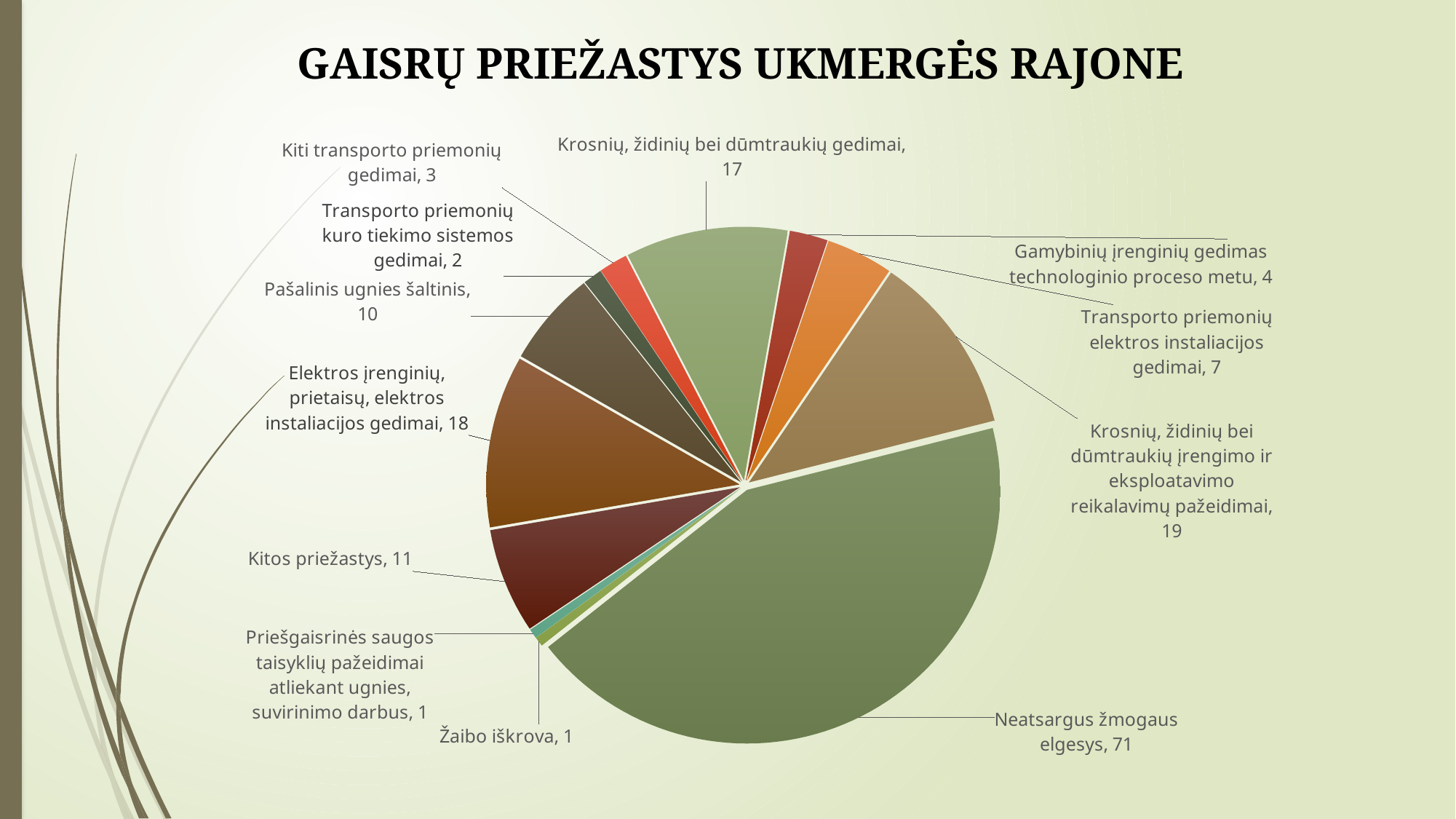
Which category has the highest value? Neatsargus žmogaus elgesys What is the value for Kitos priežastys? 11 What is the value for Neatsargus žmogaus elgesys? 71 What is the value for Pašalinis ugnies šaltinis? 10 What is the difference between Neatsargus žmogaus elgesys and Krosnių, židinių bei dūmtraukių įrengimo ir eksploatavimo reikalavimų pažeidimai? 52 What is the difference between Elektros įrenginių, prietaisų, elektros instaliacijos gedimai and Krosnių, židinių bei dūmtraukių gedimai? 1 What is the value for Transporto priemonių elektros instaliacijos gedimai? 7 What type of chart is shown on the slide? pie chart How many categories (slices) does the pie chart have? 12 What is the title of the chart? GAISRŲ PRIEŽASTYS UKMERGĖS RAJONE Which is larger: Gamybinių įrenginių gedimas technologinio proceso metu or Kiti transporto priemonių gedimai? Gamybinių įrenginių gedimas technologinio proceso metu What is the total of all values shown in the pie chart? 164